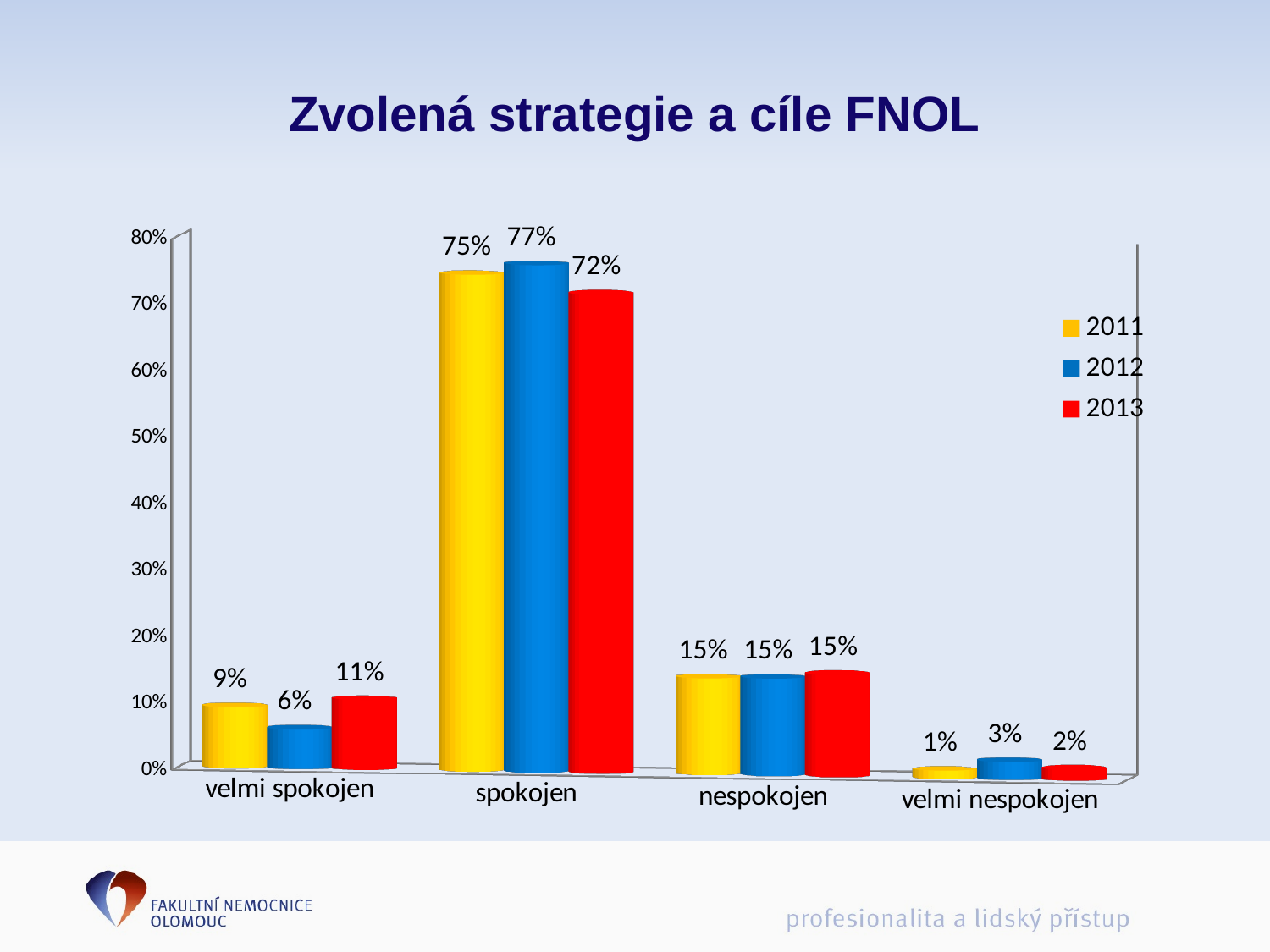
Which category has the highest value for 2013? spokojen What is the value for "spokojen" in 2012? 77% What is the value for "velmi nespokojen" in 2011? 1% How many categories are shown on the x axis? 4 What is the difference between the 2012 and 2013 values for "spokojen"? 5% Which category has the lowest value for 2012? velmi nespokojen What is the value for "velmi spokojen" in 2013? 11% Which is larger for "velmi spokojen": the 2011 value or the 2013 value? 2013 What is the value for "nespokojen" in 2011? 15% What kind of chart is shown on the slide? bar chart Which colour represents the 2013 series in the legend? red How many series does the legend list? 3